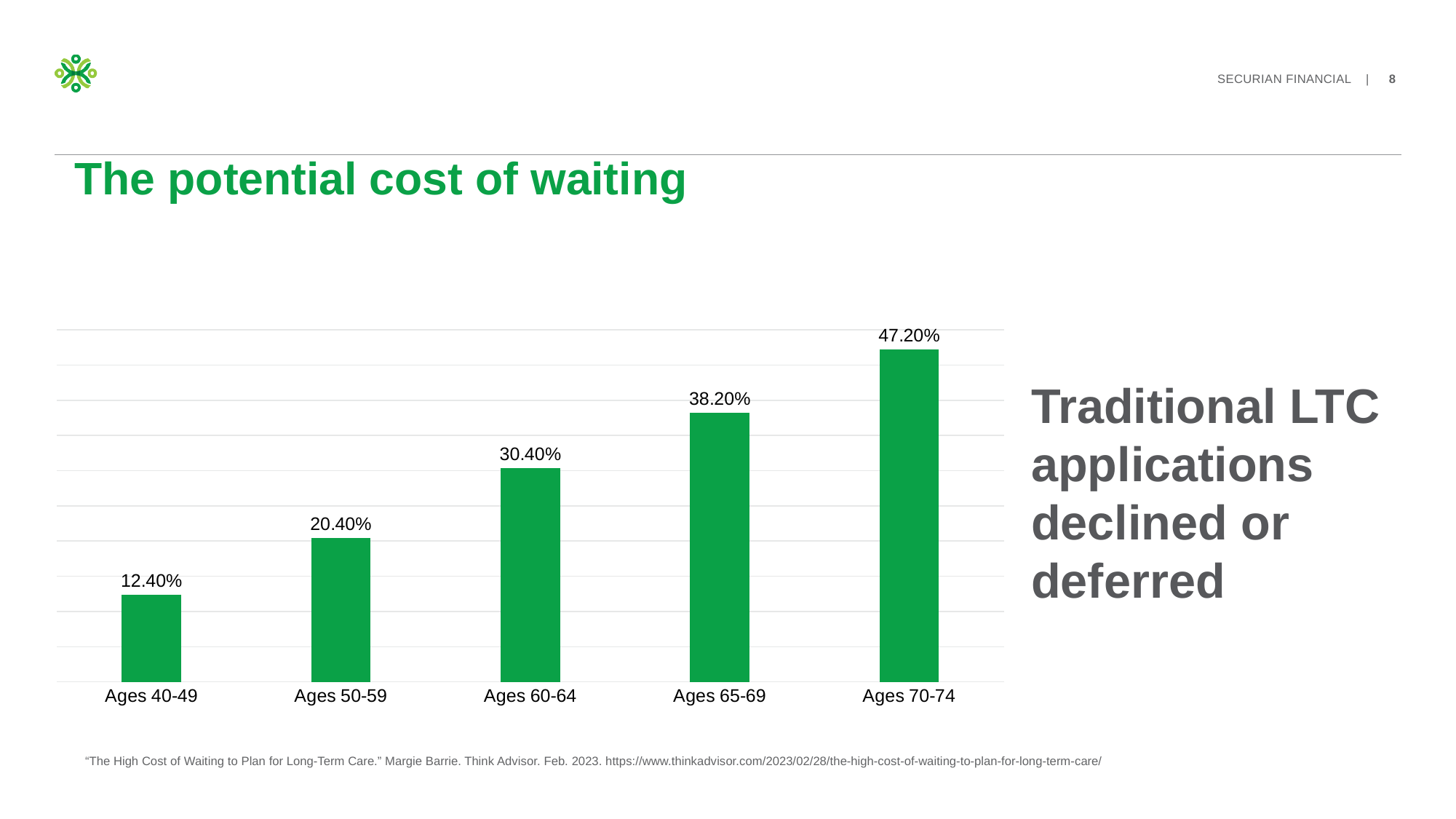
What is the difference between the values for Ages 65-69 and Ages 50-59? 17.80% What is the difference between the values for Ages 70-74 and Ages 40-49? 34.80% What kind of chart is shown on the slide? Bar chart Which age group has the lowest value? Ages 40-49 Do the values rise or fall as age increases along the x axis? Rise Which age group has the highest value? Ages 70-74 How many age groups are shown in the chart? 5 What is the value for Ages 70-74? 47.20% What is the value for Ages 60-64? 30.40% Which is larger, the value for Ages 50-59 or the value for Ages 65-69? Ages 65-69 What is the value for Ages 40-49? 12.40% What is the title of the slide containing the chart? The potential cost of waiting